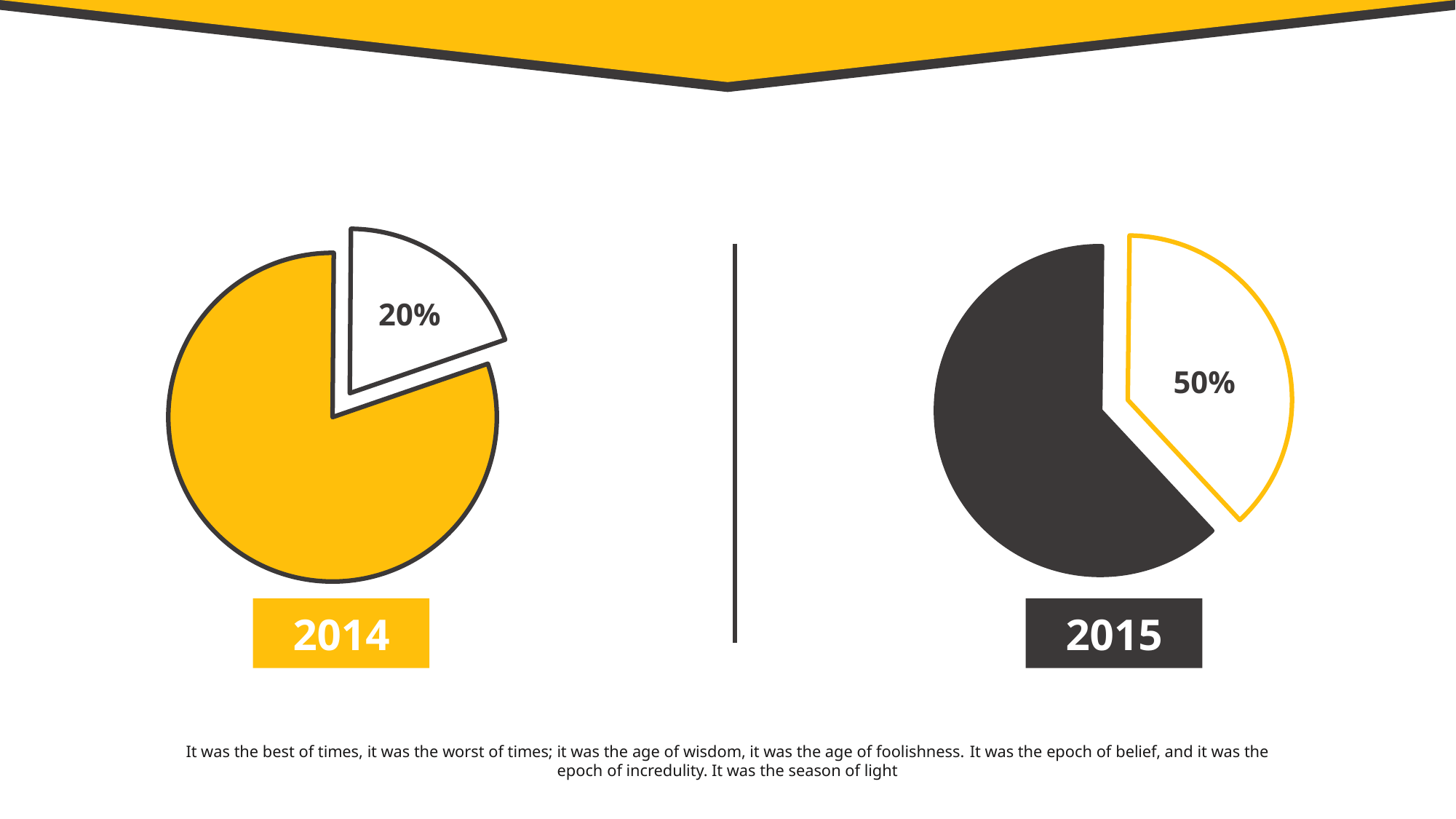
Which chart has the larger labeled slice, the 2014 chart or the 2015 chart? 2015 In the 2014 pie chart, what colour is the large unlabeled slice? Yellow Which chart's labeled slice is smaller, the 2014 chart or the 2015 chart? 2014 How many slices does the 2015 pie chart have? 2 In the 2014 pie chart, what percentage is printed on the exploded slice? 20% What kind of chart is shown above the 2014 label? Pie chart How many slices does the 2014 pie chart have? 2 How many pie charts are shown on the slide? 2 What is the difference between the labeled slice in the 2015 chart and the labeled slice in the 2014 chart? 30% In the 2015 pie chart, what colour is the large unlabeled slice? Dark grey In the 2015 pie chart, what percentage is printed on the exploded slice? 50%